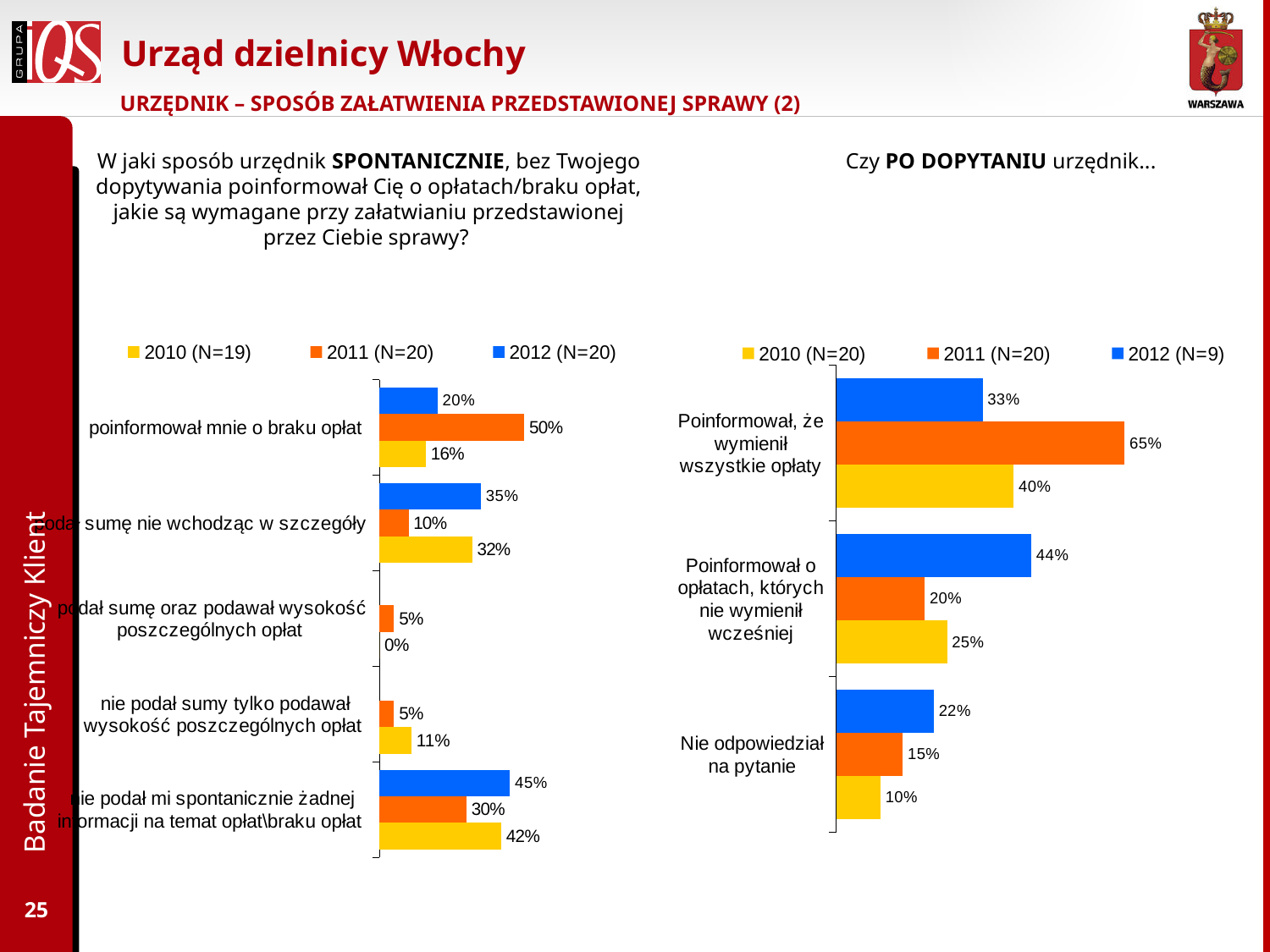
In the left chart (SPONTANICZNIE), how many categories are shown? 5 In the right chart (PO DOPYTANIU), which year has the lowest value for "Nie odpowiedział na pytanie"? 2010 (N=20) In the right chart (PO DOPYTANIU), what is the 2012 (N=9) value for "Poinformował o opłatach, których nie wymienił wcześniej"? 44% What type of chart is the right chart (PO DOPYTANIU)? bar chart In the left chart (SPONTANICZNIE), what is the difference between the 2011 and 2010 values for "poinformował mnie o braku opłat"? 34% In the right chart (PO DOPYTANIU), is the 2010 value for "Poinformował, że wymienił wszystkie opłaty" larger or smaller than the 2012 value? larger In the left chart (SPONTANICZNIE), what is the 2010 (N=19) value for "nie podał mi spontanicznie żadnej informacji na temat opłat\braku opłat"? 42% In the left chart (SPONTANICZNIE), which category has the highest 2012 (N=20) value? nie podał mi spontanicznie żadnej informacji na temat opłat\braku opłat In the left chart (SPONTANICZNIE), what is the 2012 (N=20) value for "podał sumę nie wchodząc w szczegóły"? 35% In the right chart (PO DOPYTANIU), how many series does the legend list? 3 In the left chart (SPONTANICZNIE), what is the 2011 (N=20) value for "poinformował mnie o braku opłat"? 50% In the right chart (PO DOPYTANIU), what is the 2011 (N=20) value for "Poinformował, że wymienił wszystkie opłaty"? 65%